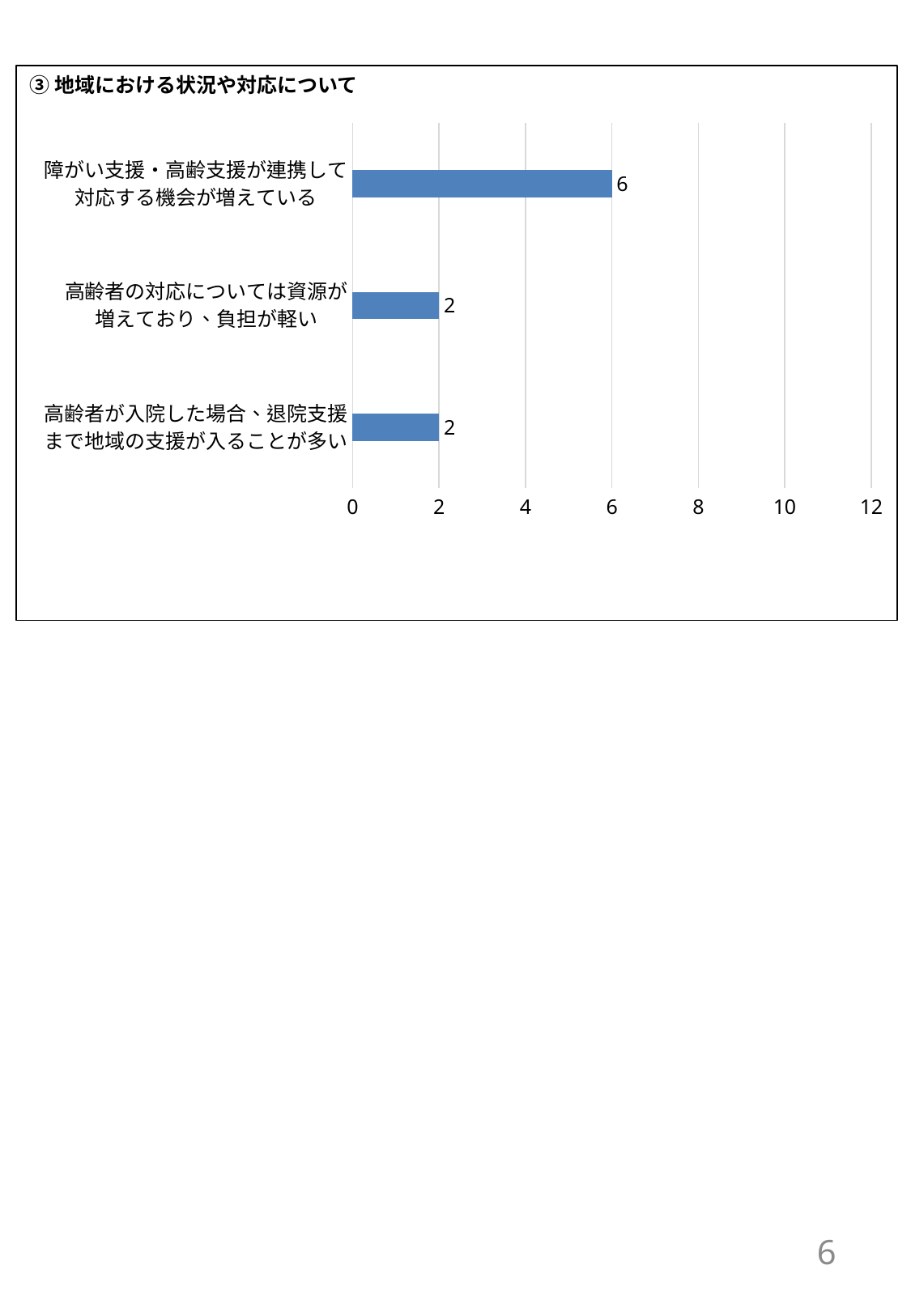
Is the value for 障がい支援・高齢支援が連携して対応する機会が増えている greater or less than 4? greater Which is larger: the value for 障がい支援・高齢支援が連携して対応する機会が増えている or the value for 高齢者が入院した場合、退院支援まで地域の支援が入ることが多い? 障がい支援・高齢支援が連携して対応する機会が増えている What is the title of the chart? ③ 地域における状況や対応について Which category has the highest value? 障がい支援・高齢支援が連携して対応する機会が増えている What is the value for 高齢者の対応については資源が増えており、負担が軽い? 2 How many categories are shown in the chart? 3 What is the difference between the value for 障がい支援・高齢支援が連携して対応する機会が増えている and the value for 高齢者の対応については資源が増えており、負担が軽い? 4 Is the value for 高齢者の対応については資源が増えており、負担が軽い greater or less than 4? less What is the value for 高齢者が入院した場合、退院支援まで地域の支援が入ることが多い? 2 What kind of chart is shown on the slide? bar chart What is the value for 障がい支援・高齢支援が連携して対応する機会が増えている? 6 What is the maximum value shown on the horizontal axis? 12